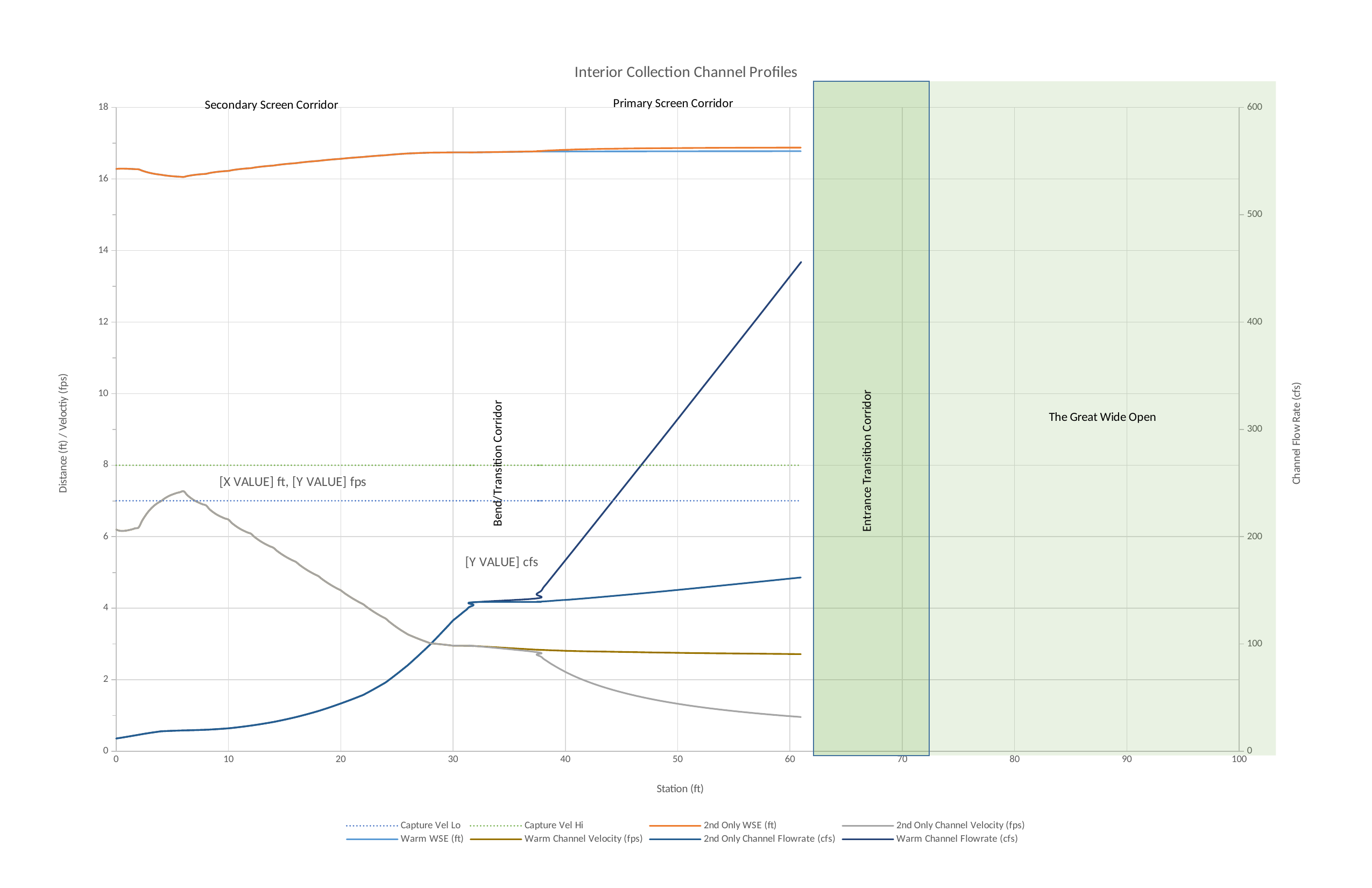
How many series does the chart legend list? 8 Is the 2nd Only Channel Velocity (fps) value at station 60 greater or less than 2? less Is the Warm Channel Velocity (fps) value at station 60 greater or less than 4? less Does the 2nd Only Channel Velocity (fps) series rise or fall between station 10 and station 60? fall Is the Warm Channel Flowrate (cfs) value at station 60 greater or less than 400 on the right axis? greater What is the label of the x axis? Station (ft) At station 60, which is larger: Warm Channel Flowrate (cfs) or 2nd Only Channel Flowrate (cfs)? Warm Channel Flowrate (cfs) What kind of chart is shown on the slide? line chart At what value on the left axis does the Capture Vel Lo line sit? 7 At what value on the left axis does the Capture Vel Hi line sit? 8 What is the title of the chart? Interior Collection Channel Profiles